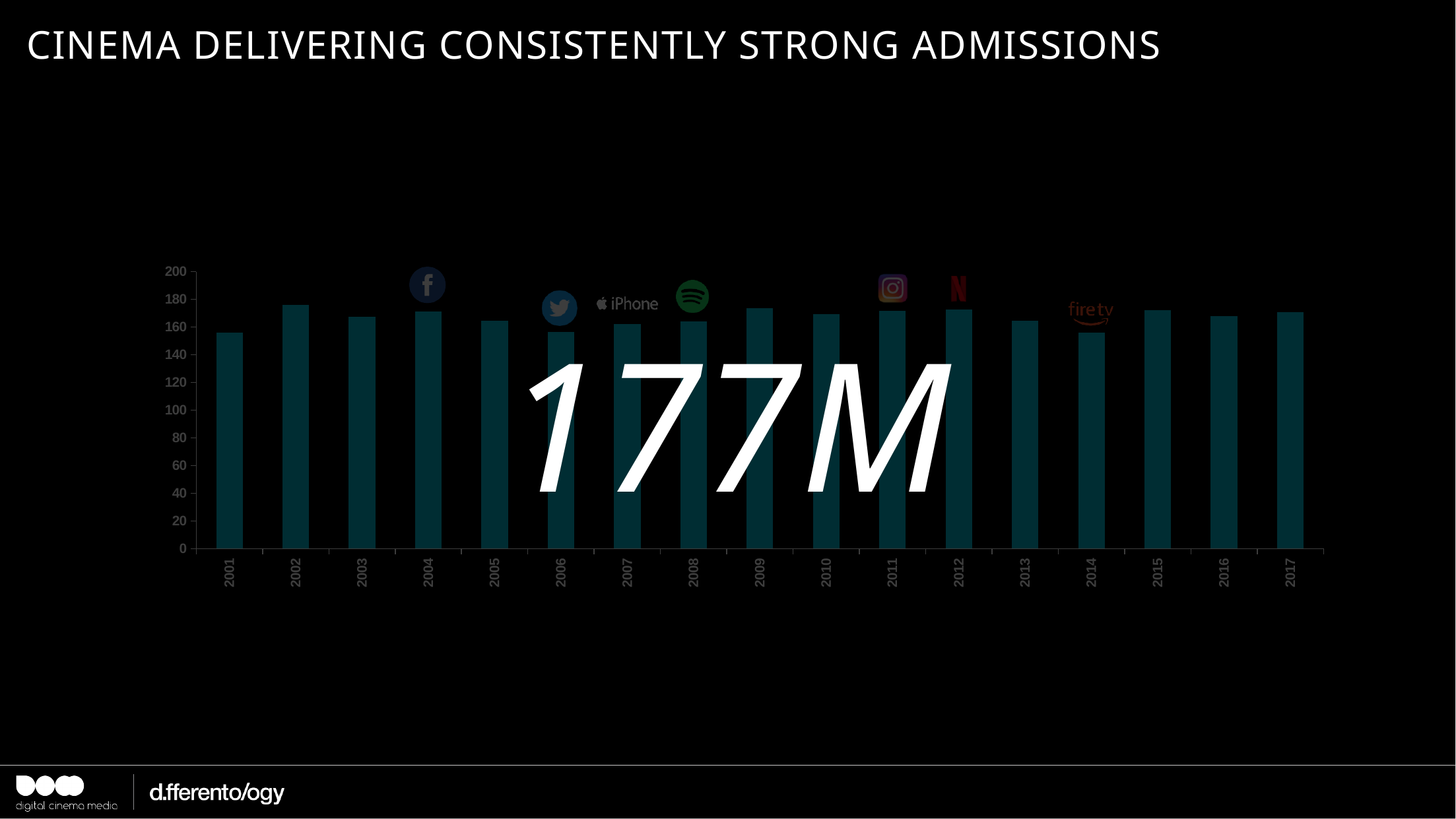
Which is larger, the value for 2014 or the value for 2004? 2004 Do the values clearly rise, clearly fall, or stay roughly flat from 2001 to 2017? roughly flat What is the first year shown on the x axis of the chart? 2001 Is the value for 2017 greater or less than 120? greater Is the value for 2001 greater or less than 140? greater What kind of chart is shown on the slide? bar chart Which is larger, the value for 2002 or the value for 2001? 2002 What is the last year shown on the x axis of the chart? 2017 Is the value for 2002 greater or less than 160? greater How many years are plotted along the x axis of the chart? 17